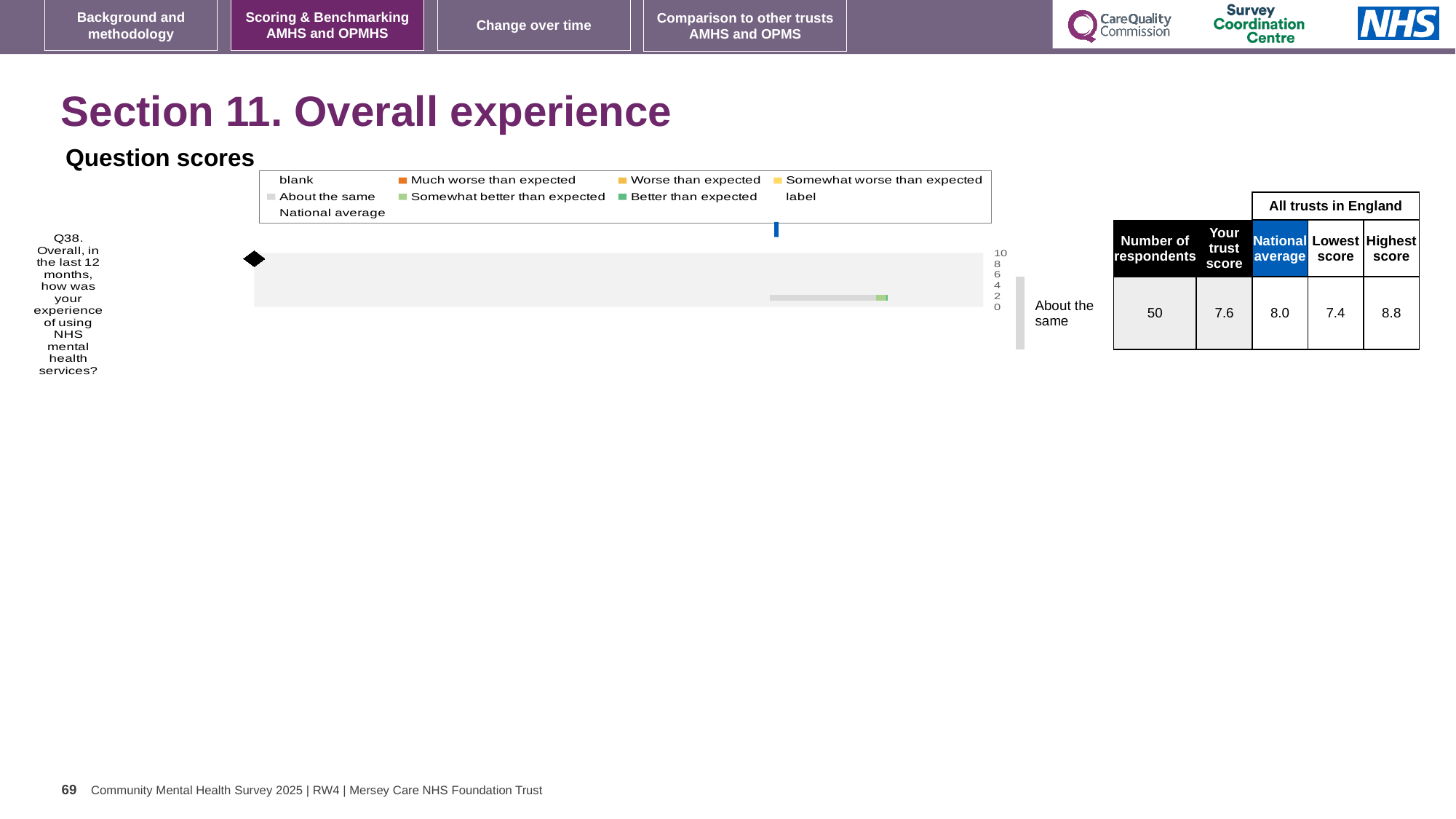
For Q38, is the trust score larger or smaller than the national average shown in the table beside the chart? smaller In the table beside the Question scores chart, what is the lowest score among all trusts in England for Q38? 7.4 How many questions (categories) are plotted in the Question scores chart? 1 For Q38, what is the difference between the highest score and the lowest score shown in the table beside the chart? 1.4 In the table beside the Question scores chart, what is the trust score for Q38? 7.6 In the table beside the Question scores chart, what is the national average for Q38? 8.0 Which question is plotted in the Question scores chart? Q38. Overall, in the last 12 months, how was your experience of using NHS mental health services? Which legend entry in the Question scores chart is shown in orange? Much worse than expected What benchmark category is shown next to the bar for Q38 in the Question scores chart? About the same What kind of chart is shown under 'Question scores'? bar chart In the table beside the Question scores chart, what is the highest score among all trusts in England for Q38? 8.8 In the table beside the Question scores chart, what is the number of respondents for Q38? 50